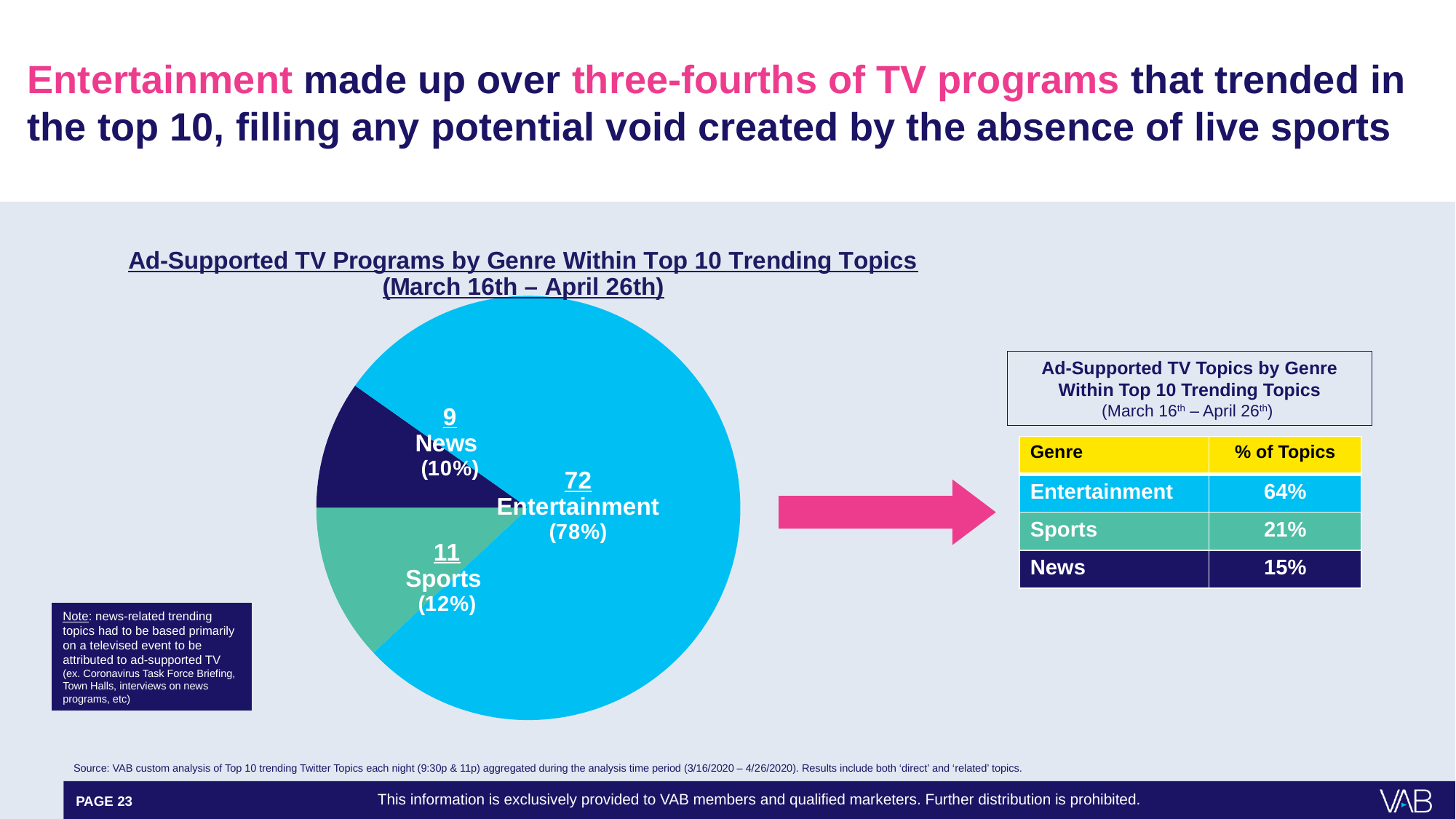
What is the value for News in the pie chart? 9 What is the value for Sports in the pie chart? 11 What is the title of the pie chart? Ad-Supported TV Programs by Genre Within Top 10 Trending Topics (March 16th – April 26th) Which genre has the smallest slice in the pie chart? News What is the value for Entertainment in the pie chart? 72 What kind of chart is shown on the slide? pie chart How many slices does the pie chart have? 3 What is the difference between the Entertainment and Sports values in the pie chart? 61 Which is larger in the pie chart, Sports or News? Sports What share of the pie does News represent? 10% What share of the pie does Entertainment represent? 78% Which genre has the largest slice in the pie chart? Entertainment